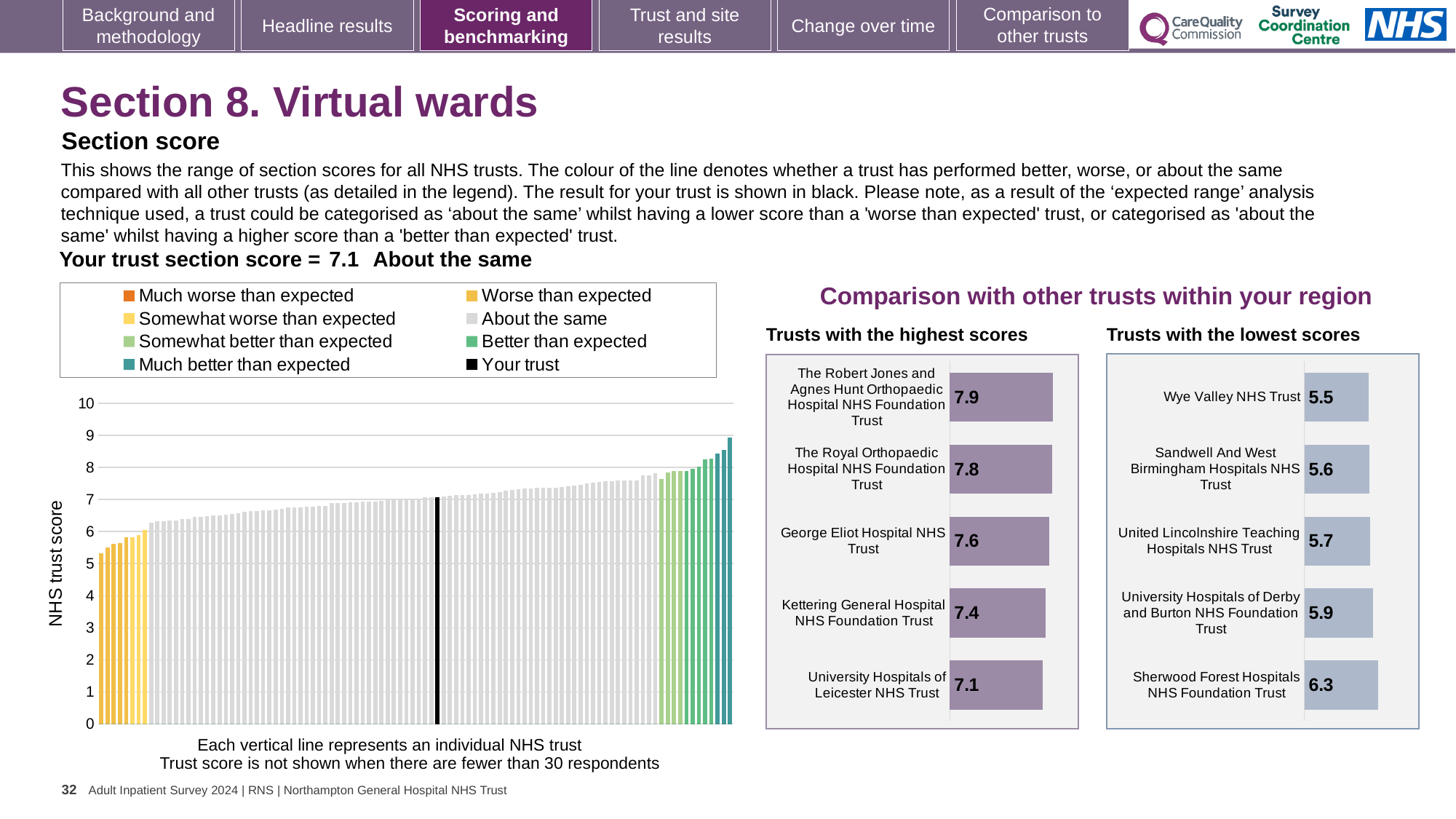
How many trusts are shown in the 'Trusts with the lowest scores' chart? 5 In the 'Trusts with the lowest scores' chart, which has the larger score: Sherwood Forest Hospitals NHS Foundation Trust or United Lincolnshire Teaching Hospitals NHS Trust? Sherwood Forest Hospitals NHS Foundation Trust What type of chart is the 'Trusts with the highest scores' chart? Bar chart In the 'Trusts with the highest scores' chart, what is the score for George Eliot Hospital NHS Trust? 7.6 In the 'Trusts with the lowest scores' chart, what is the score for Wye Valley NHS Trust? 5.5 In the main NHS trust score chart on the left, do the bar values rise or fall from left to right? Rise In the main NHS trust score chart on the left, is the value of the tallest bar greater or less than 8? greater In the 'Trusts with the highest scores' chart, which trust has the highest score? The Robert Jones and Agnes Hunt Orthopaedic Hospital NHS Foundation Trust How many entries does the legend of the main NHS trust score chart list? 8 In the 'Trusts with the lowest scores' chart, which trust has the lowest score? Wye Valley NHS Trust In the main NHS trust score chart on the left, what is the section score for your trust (the black bar)? 7.1 In the 'Trusts with the highest scores' chart, what is the difference between the scores of The Royal Orthopaedic Hospital NHS Foundation Trust and Kettering General Hospital NHS Foundation Trust? 0.4